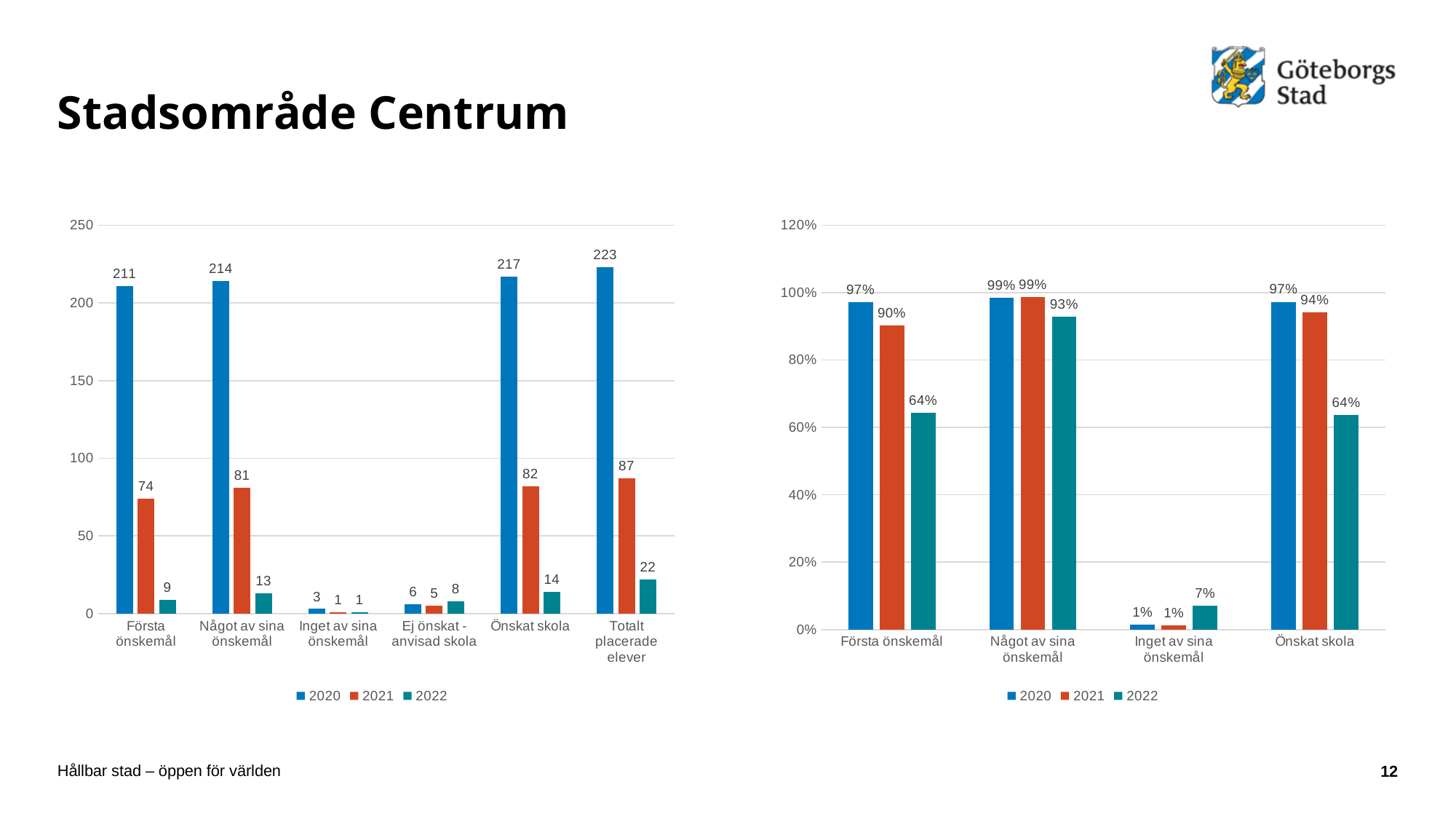
In the right chart, which category has the lowest value for 2020? Inget av sina önskemål In the left chart, how many categories are shown on the x axis? 6 In the left chart, what is the difference between the 2020 and 2021 values for 'Önskat skola'? 135 In the left chart, what is the value for 2022 in the 'Första önskemål' category? 9 In the right chart, what is the difference between the 2020 and 2022 values for 'Önskat skola'? 33% In the left chart, is the 2020 value for 'Något av sina önskemål' greater or less than 200? greater How many series does the legend of the right chart list? 3 In the right chart, which is larger for 'Första önskemål': the 2021 value or the 2022 value? 2021 In the left chart, what is the value for 2020 in the 'Totalt placerade elever' category? 223 What kind of chart is the left chart? Bar chart In the left chart, which category has the highest value for 2021? Totalt placerade elever In the right chart, what is the value for 2022 in the 'Något av sina önskemål' category? 93%